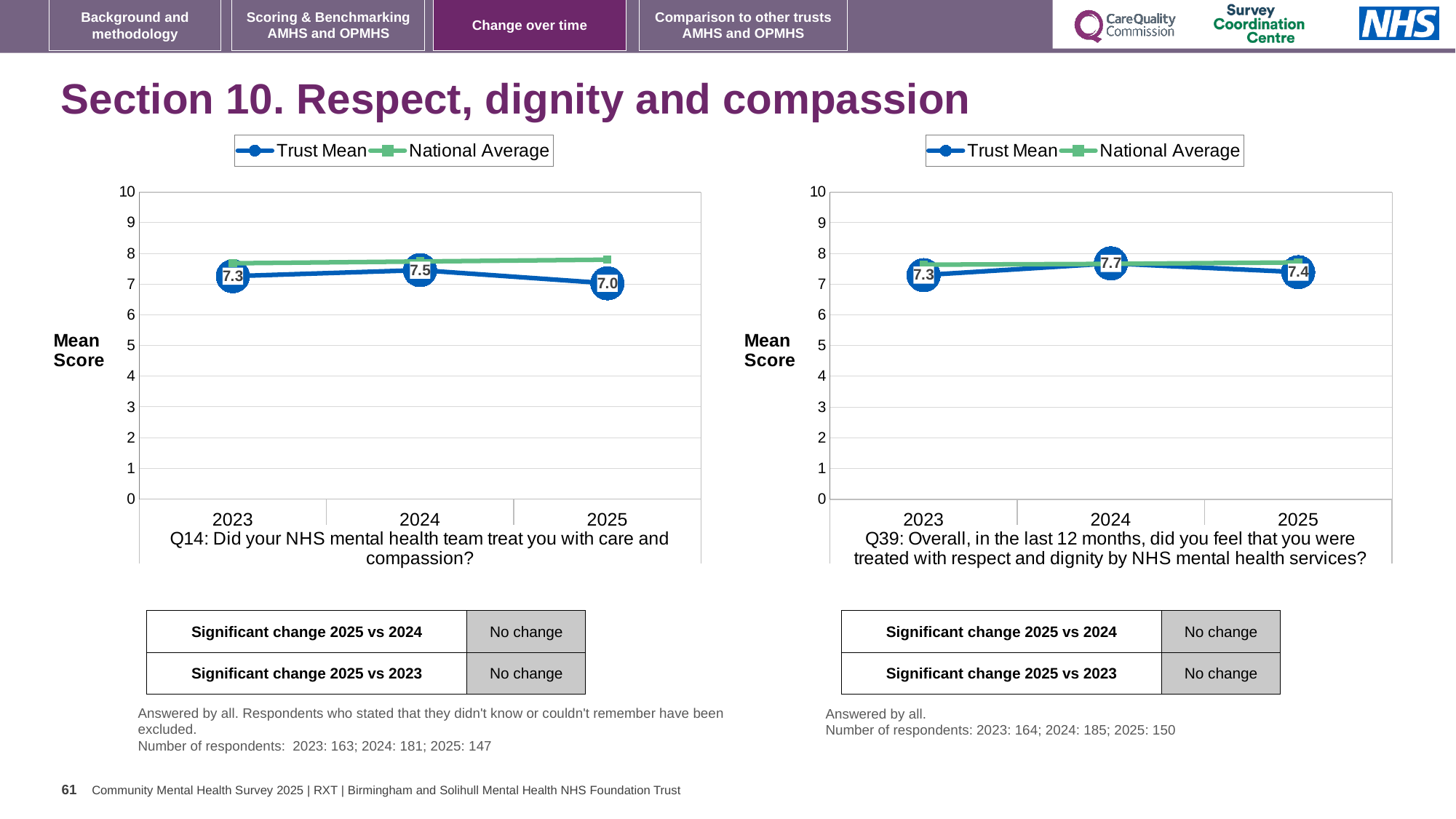
In the Q14 chart on the left, what is the difference between the Trust Mean for 2024 and 2025? 0.5 In the Q39 chart on the right, what is the difference between the Trust Mean for 2023 and 2024? 0.4 In the Q39 chart on the right, is the National Average for 2023 greater or less than 7? greater In the Q39 chart on the right, which year has the highest Trust Mean? 2024 What kind of chart is the Q39 chart on the right? Line chart In the Q39 chart on the right, what is the Trust Mean for 2025? 7.4 In the Q14 chart on the left, what is the Trust Mean for 2025? 7.0 In the Q39 chart on the right, what is the Trust Mean for 2024? 7.7 In the Q14 chart on the left, which year has the lowest Trust Mean? 2025 How many series does the legend of the Q14 chart on the left list? 2 In the Q14 chart on the left, what is the Trust Mean for 2024? 7.5 In the Q14 chart on the left, is the Trust Mean or the National Average higher in 2025? National Average